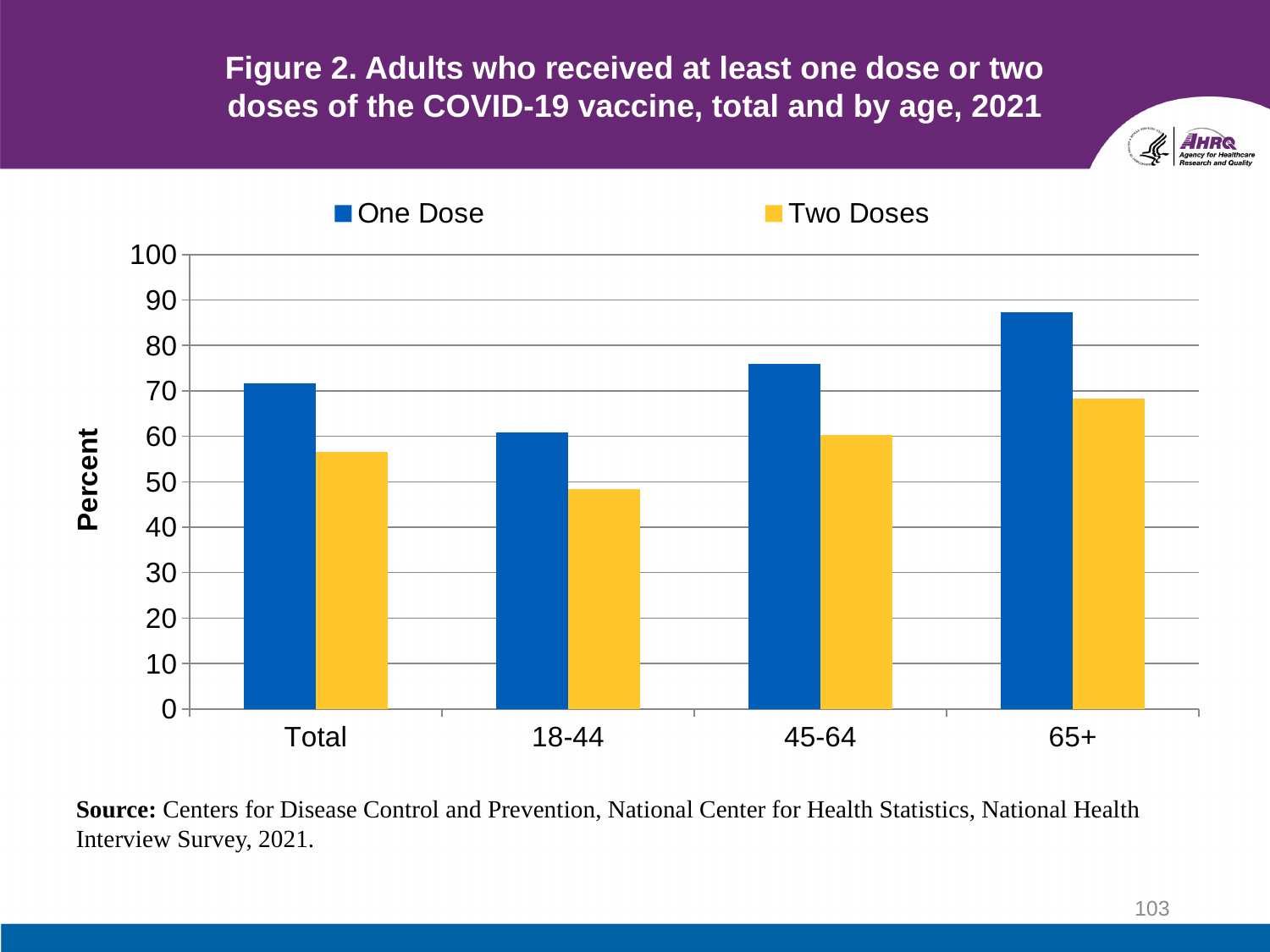
Is the One Dose value for Total greater or less than 60? greater Is the Two Doses value for 45-64 greater or less than 50? greater Which is larger for the 45-64 group, the One Dose value or the Two Doses value? One Dose Is the One Dose value for 65+ greater or less than 80? greater How many series does the legend list? 2 Which category has the highest One Dose value? 65+ What type of chart is shown on the slide? bar chart How many age categories are shown on the x axis? 4 Which category has the lowest Two Doses value? 18-44 What is the label of the y axis? Percent Do the One Dose values rise or fall from the 18-44 group to the 65+ group? rise